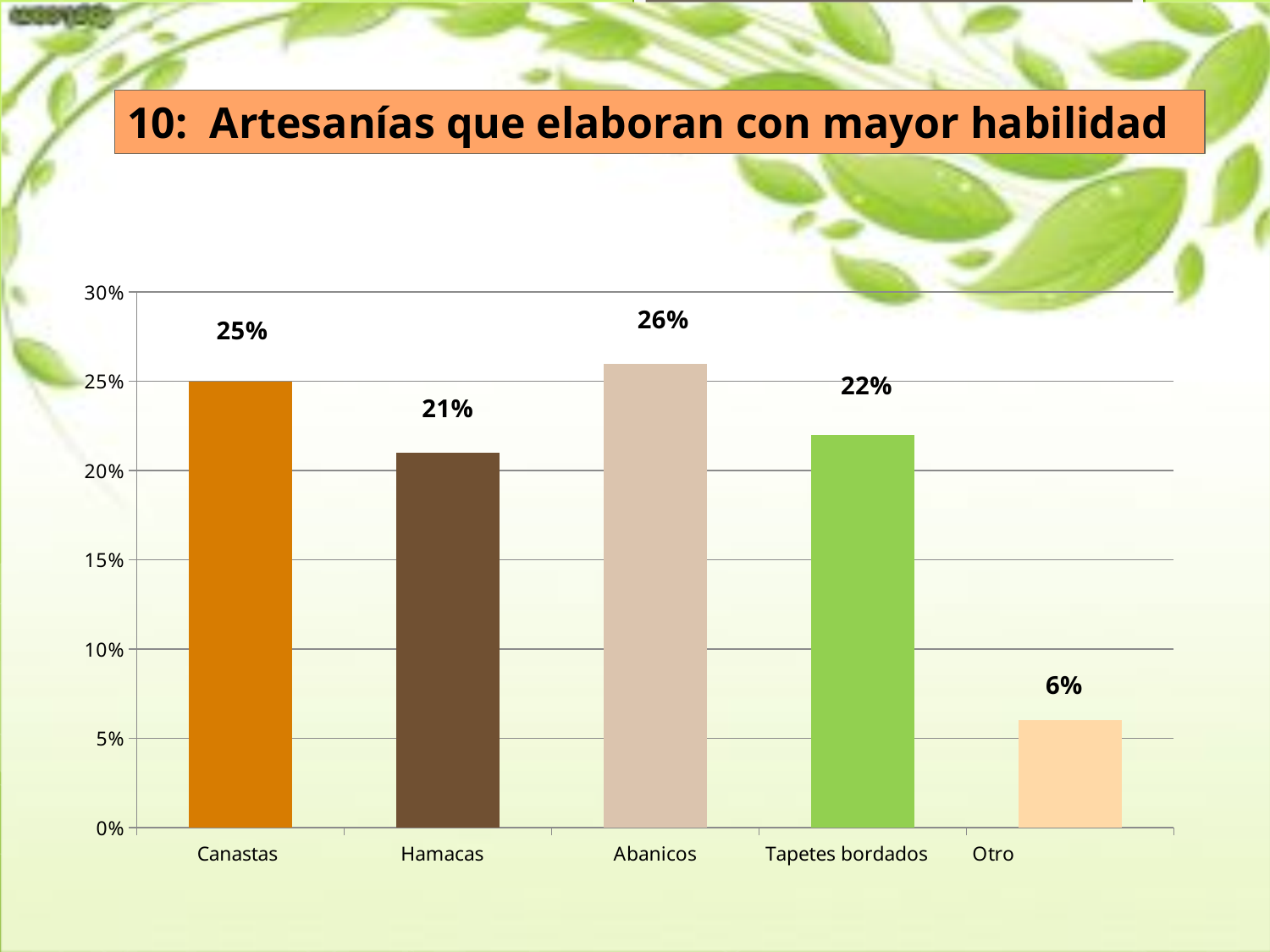
What is the value for Tapetes bordados? 22% Which category has the lowest value? Otro Which is larger, the value for Tapetes bordados or the value for Hamacas? Tapetes bordados How many categories are shown on the x axis? 5 What kind of chart is shown on the slide? bar chart What is the difference between the values for Abanicos and Otro? 20% What is the difference between the values for Canastas and Hamacas? 4% What is the value for Hamacas? 21% Is the value for Otro greater or less than 10%? less Which category has the highest value? Abanicos What is the value for Otro? 6% What is the value for Canastas? 25%